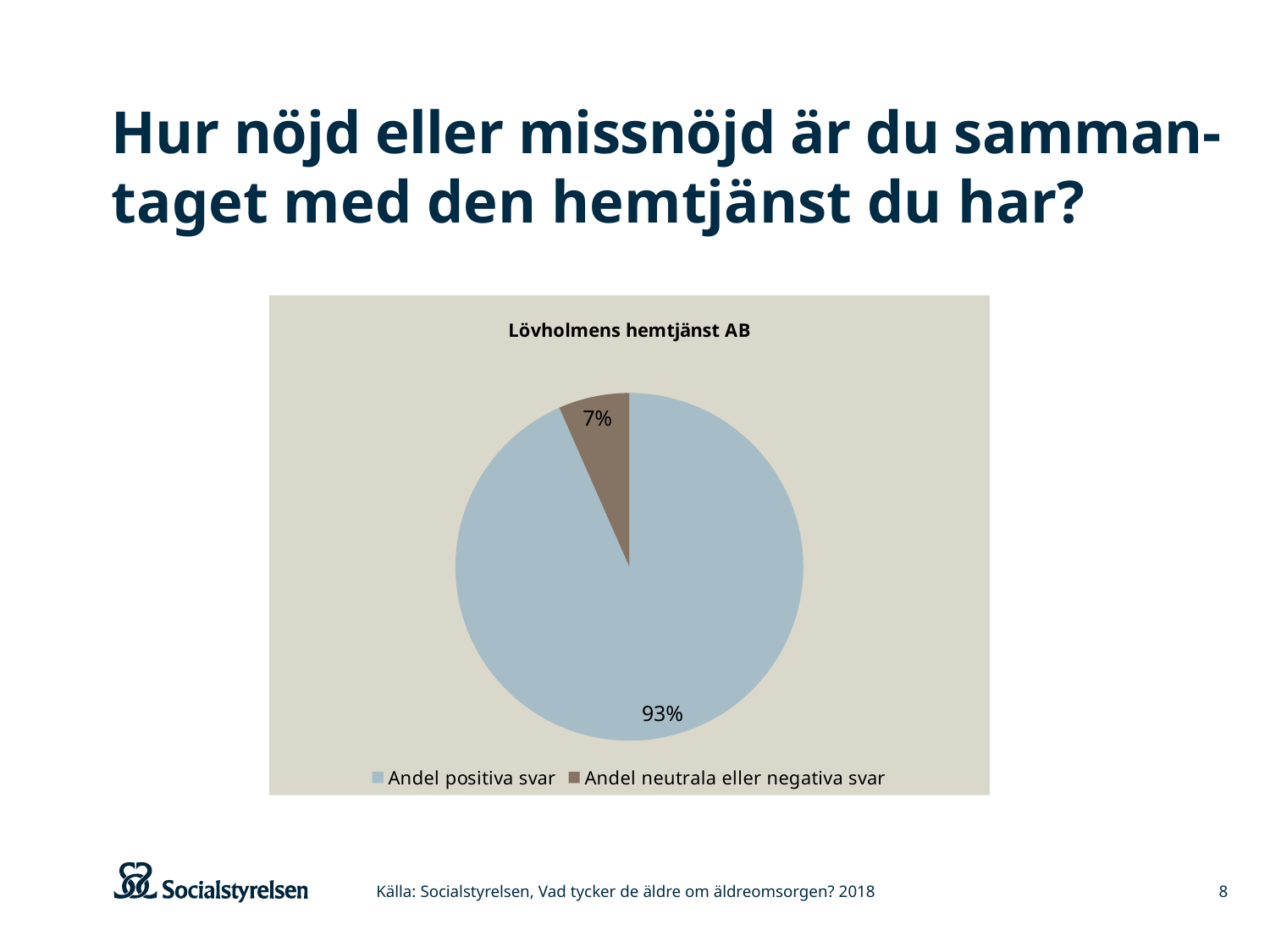
Which legend entry is shown in brown? Andel neutrala eller negativa svar What share of the pie is 'Andel neutrala eller negativa svar'? 7% How many entries does the legend list? 2 Which is larger: 'Andel positiva svar' or 'Andel neutrala eller negativa svar'? Andel positiva svar How many slices does the pie chart have? 2 What share of the pie is 'Andel positiva svar'? 93% Which slice is the smallest? Andel neutrala eller negativa svar What is the difference between the 'Andel positiva svar' share and the 'Andel neutrala eller negativa svar' share? 86% What is the total of the two slices shown? 100% Which slice is the largest? Andel positiva svar What type of chart is shown on the slide? pie chart What is the title of the chart? Lövholmens hemtjänst AB